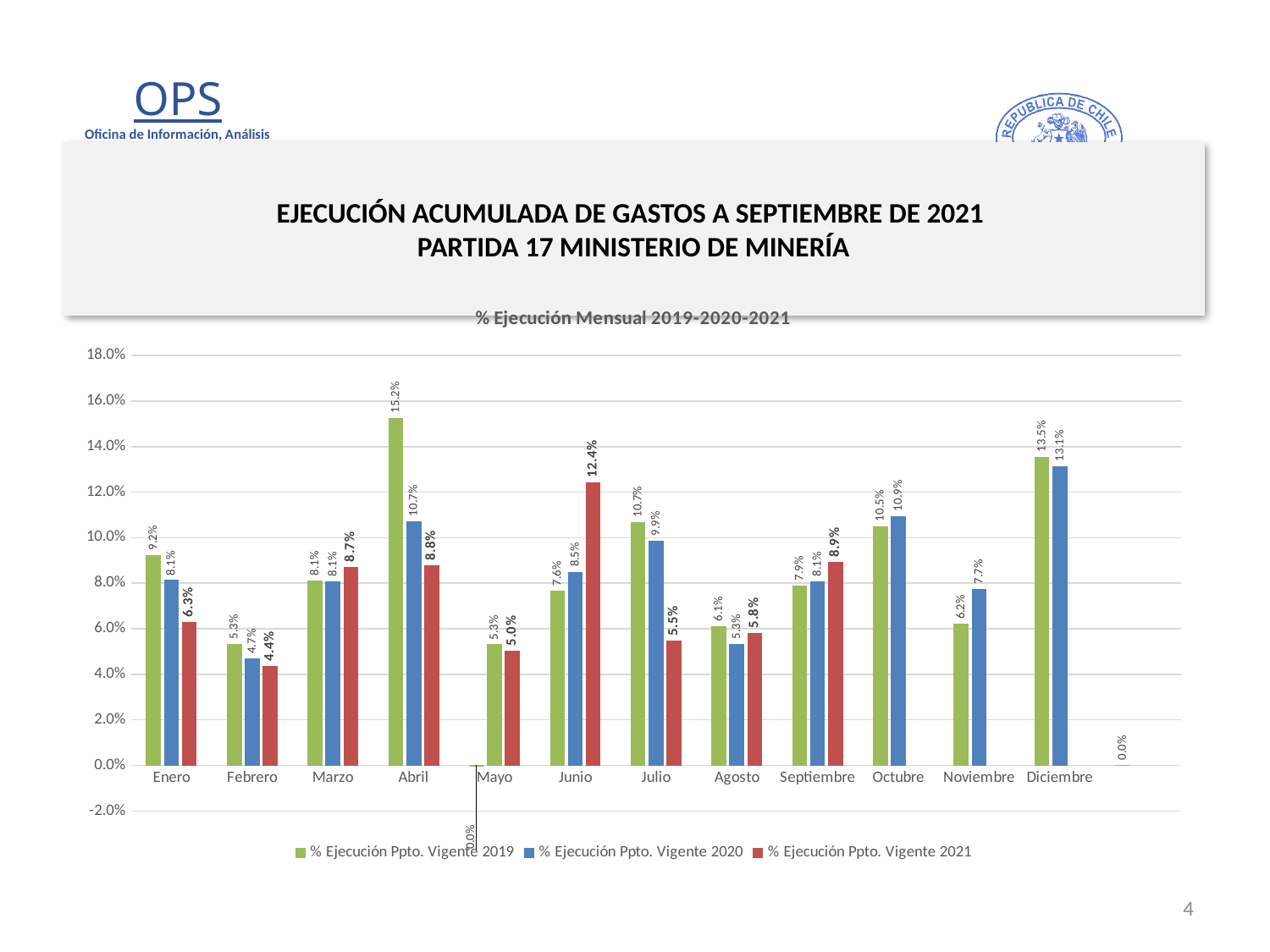
What kind of chart is shown on the slide? Bar chart In which month is the % Ejecución Ppto. Vigente 2021 series highest? Junio What is the title of the chart? % Ejecución Mensual 2019-2020-2021 What is the value for % Ejecución Ppto. Vigente 2021 in Junio? 12.4% How many months are shown on the x axis? 12 What is the value for % Ejecución Ppto. Vigente 2020 in Diciembre? 13.1% What is the difference between the 2019 and 2020 values in Abril? 4.5% How many series does the legend list? 3 What is the value for % Ejecución Ppto. Vigente 2019 in Abril? 15.2% In Julio, which is larger: the 2019 value or the 2021 value? 2019 In which month is the % Ejecución Ppto. Vigente 2019 series highest? Abril In which month is the % Ejecución Ppto. Vigente 2020 series lowest? Febrero